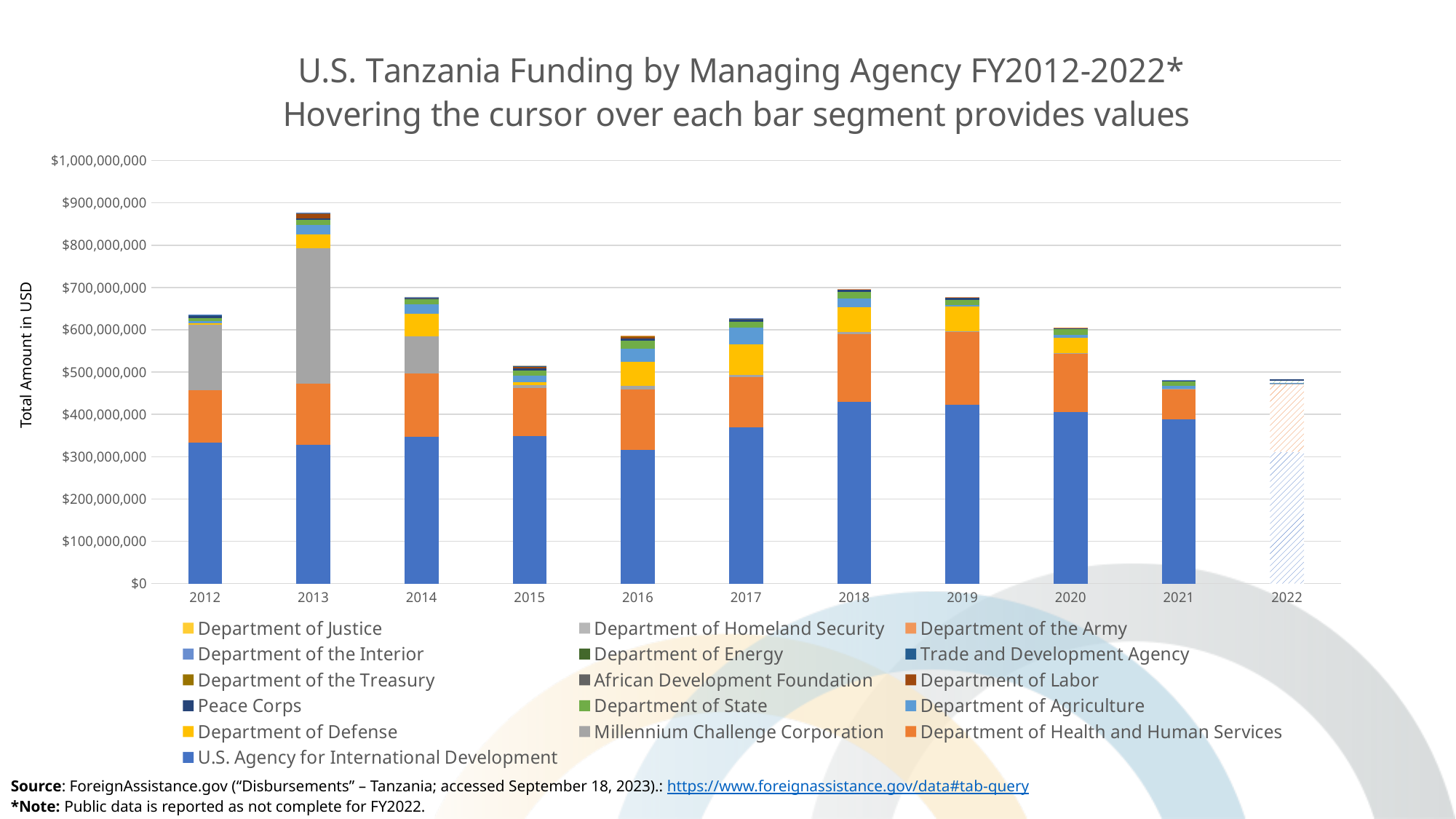
Is the total funding for 2018 greater or less than $600,000,000? greater Do the total funding amounts rise or fall from 2018 to 2021? fall Which year has the larger total funding, 2020 or 2021? 2020 What type of chart is shown on the slide? Stacked bar chart Is the total funding for 2013 greater or less than $800,000,000? greater Which year has the larger total funding, 2013 or 2018? 2013 Is the total funding for 2015 greater or less than $600,000,000? less How many managing agencies does the legend list? 16 Which fiscal year has the highest total funding? 2013 What is the label on the y axis? Total Amount in USD How many fiscal years are shown along the x axis? 11